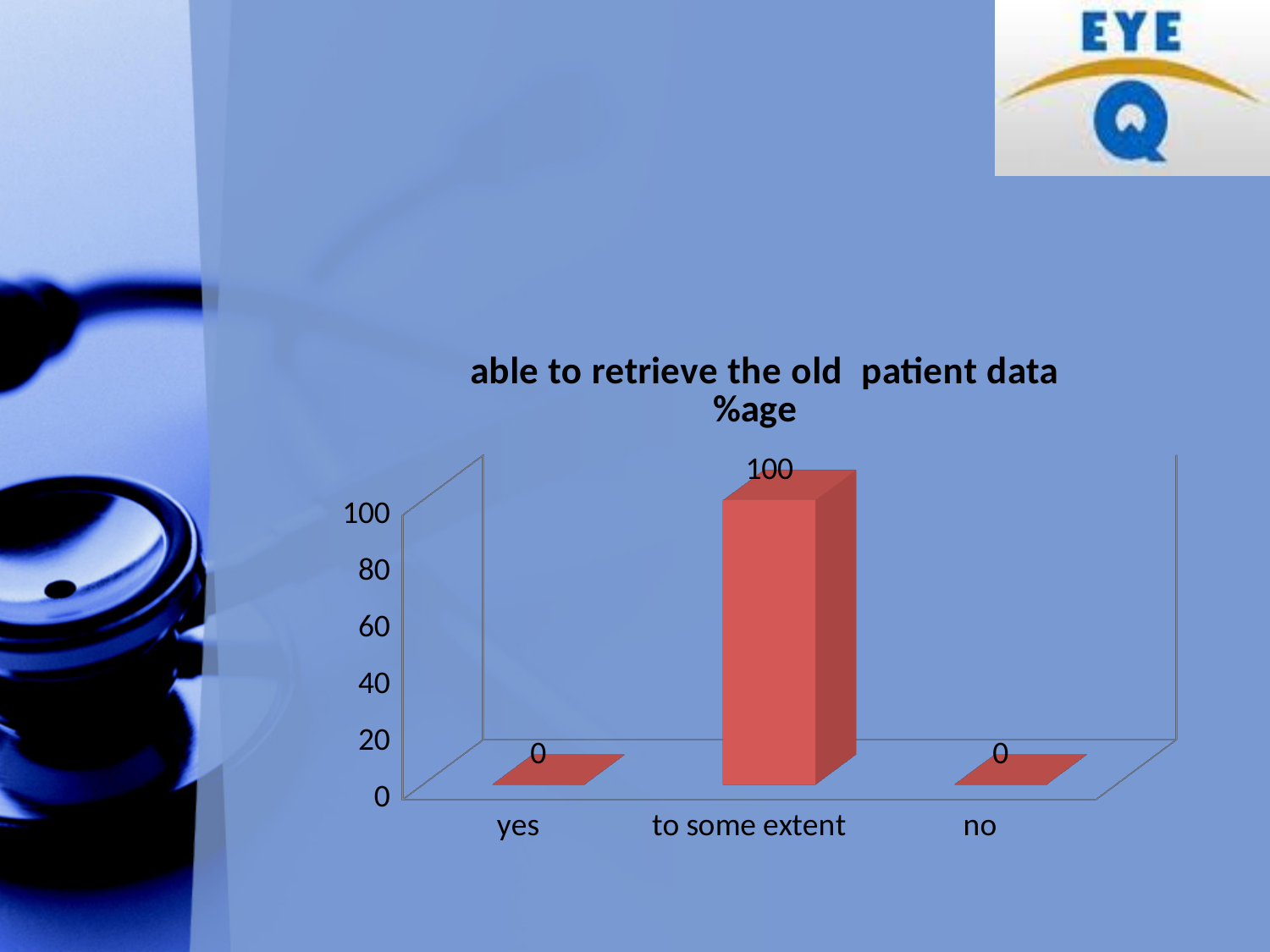
What is the value for "to some extent"? 100 Which category has the highest value? to some extent What kind of chart is shown on the slide? bar chart How many categories are shown on the x axis? 3 What is the highest value shown on the vertical axis? 100 What is the value for "yes"? 0 What is the value for "no"? 0 Is the value for "to some extent" greater or less than 80? greater What is the title of the chart? able to retrieve the old patient data %age What is the difference between the values for "to some extent" and "yes"? 100 Which is larger, the value for "to some extent" or the value for "no"? to some extent How many categories have a value of 0? 2